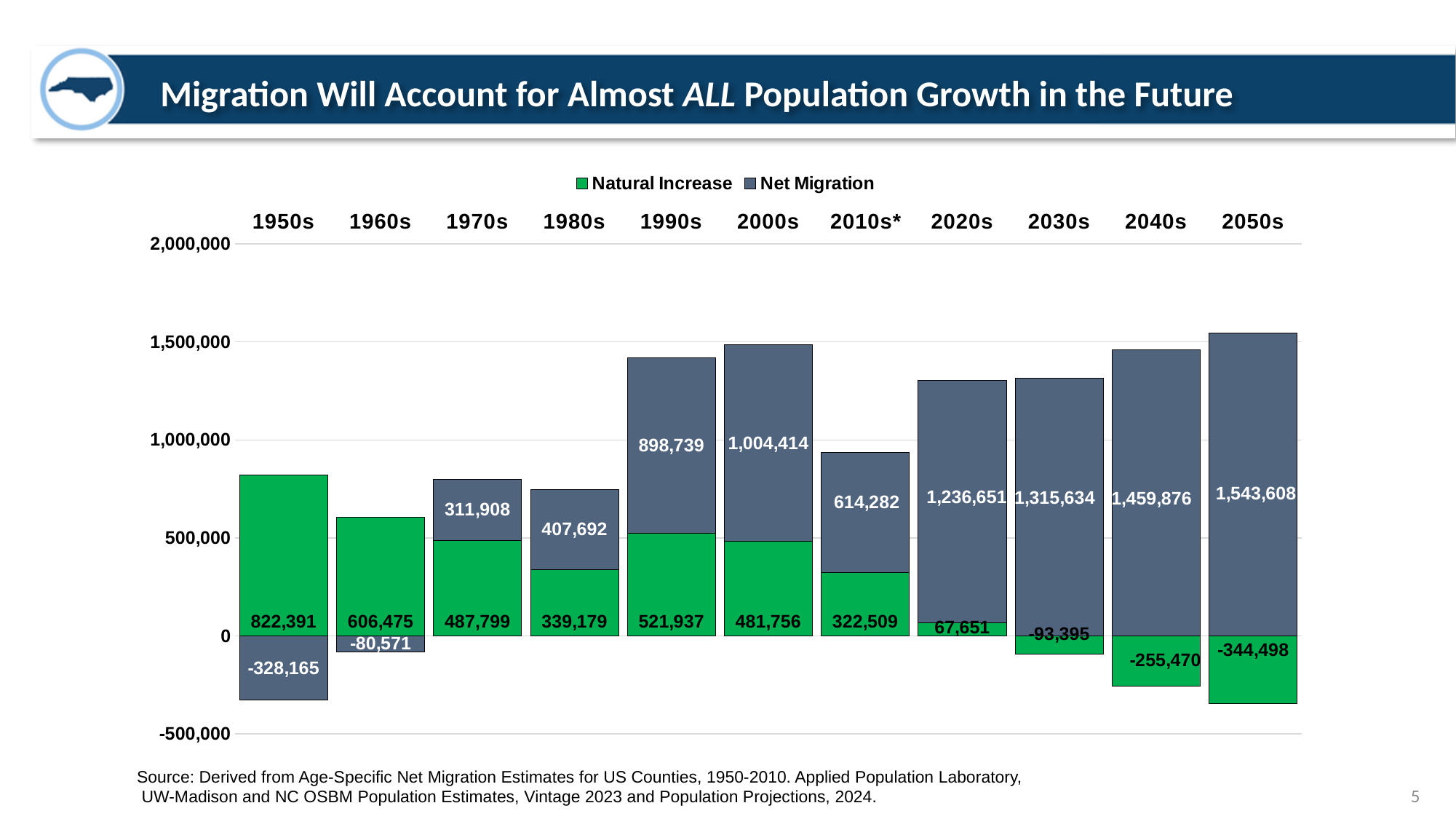
What kind of chart is shown on the slide? Stacked bar chart Is the Net Migration value for the 2010s* greater or less than 500,000? greater What is the total of Natural Increase and Net Migration for the 1990s? 1,420,676 Which decade has the larger Natural Increase value, the 1990s or the 2000s? 1990s What is the difference between the Net Migration values for the 2050s and the 2040s? 83,732 Which decade has the lowest Natural Increase value? 2050s How many decades are shown on the x axis of the chart? 11 What is the Net Migration value for the 2000s? 1,004,414 How many series does the legend list? 2 What is the Natural Increase value for the 1950s? 822,391 Which decade has the highest Net Migration value? 2050s Does the Net Migration value rise or fall from the 2020s to the 2050s? Rise